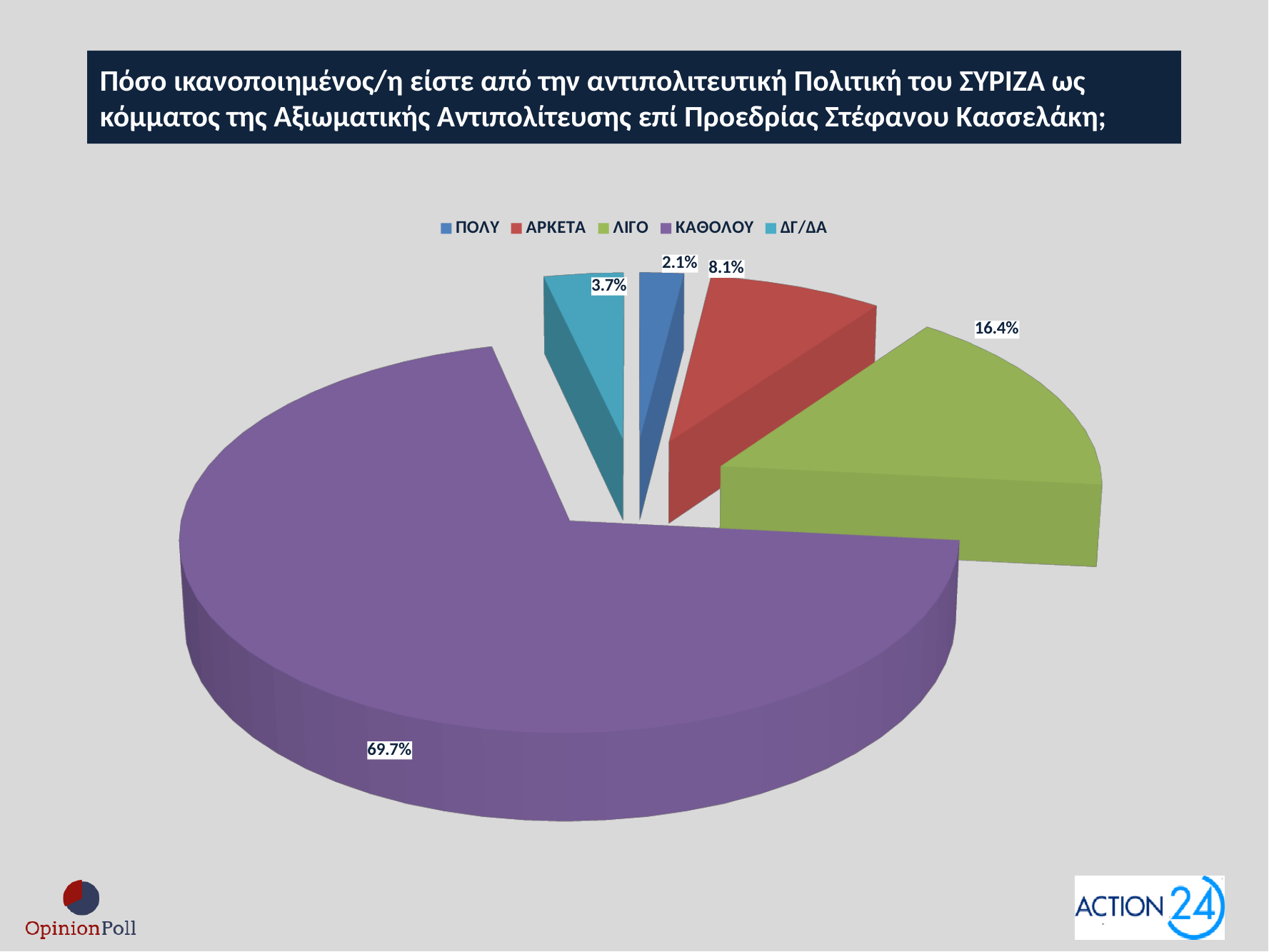
What colour is the slice for ΚΑΘΟΛΟΥ? Purple What percentage of respondents answered ΑΡΚΕΤΑ? 8.1% Which response category has the largest share of the pie? ΚΑΘΟΛΟΥ Which response category has the smallest share of the pie? ΠΟΛΥ What kind of chart is shown on the slide? Pie chart What percentage of respondents answered ΠΟΛΥ? 2.1% Which is larger, the share for ΔΓ/ΔΑ or the share for ΠΟΛΥ? ΔΓ/ΔΑ What percentage of respondents answered ΛΙΓΟ? 16.4% What percentage of respondents answered ΔΓ/ΔΑ? 3.7% How many categories does the legend list? 5 What is the difference in percentage points between ΛΙΓΟ and ΑΡΚΕΤΑ? 8.3 What percentage of respondents answered ΚΑΘΟΛΟΥ? 69.7%